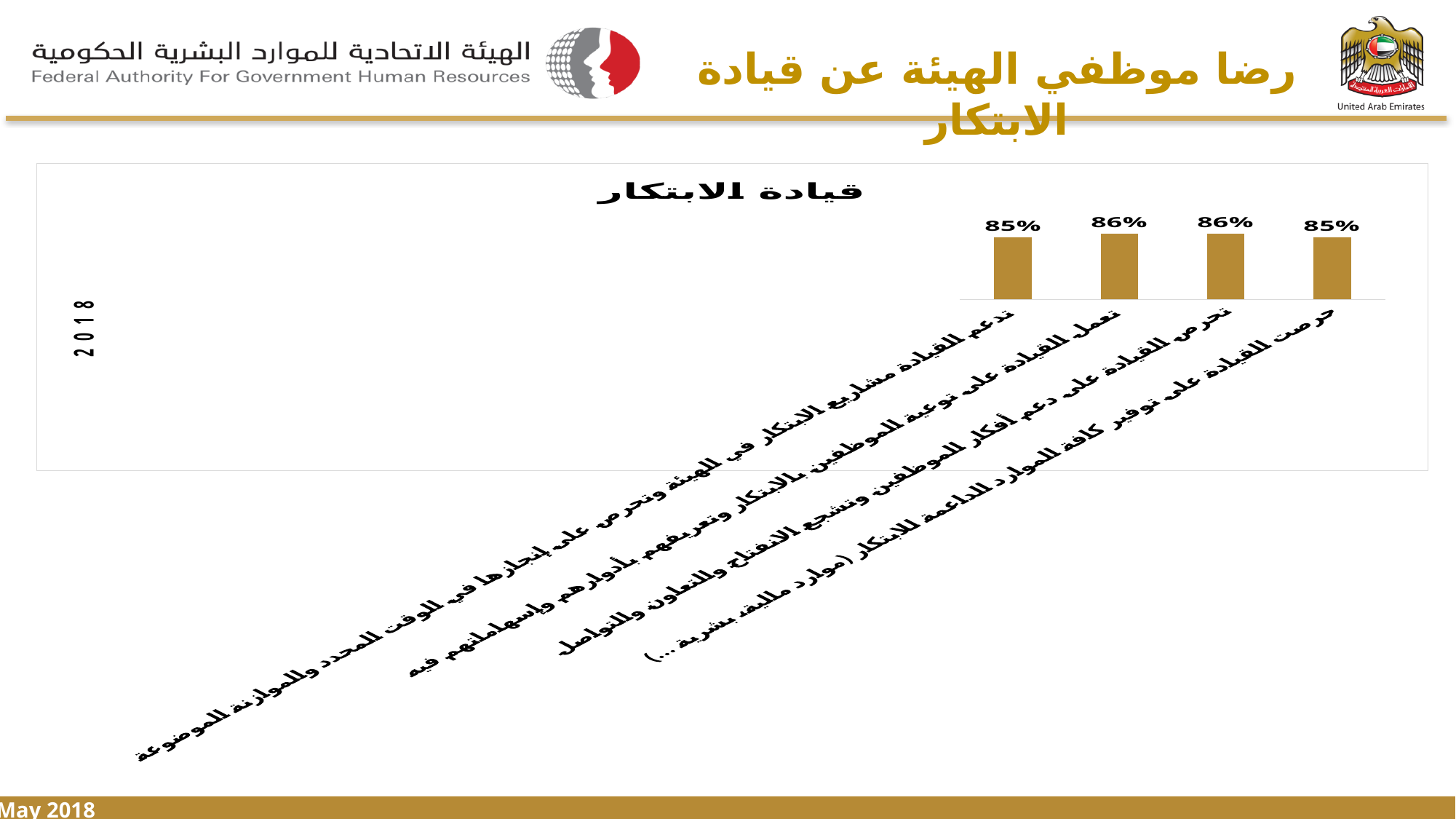
What is the value for the category "تحرص القيادة على دعم أفكار الموظفين..."? 86% What is the value for the category "تدعم القيادة مشاريع الابتكار في الهيئة..."? 85% What is the value of the rightmost bar in the chart? 85% Which year is indicated on the vertical axis label of the chart? 2018 What is the title of the chart? قيادة الابتكار What is the highest value shown in the chart? 86% What type of chart is shown on the slide? bar chart What is the value for the category "تعمل القيادة على توعية الموظفين بالابتكار..."? 86% What is the lowest value shown in the chart? 85% What is the value for the category "حرصت القيادة على توفير كافة الموارد الداعمة للابتكار..."? 85% How many bars (categories) does the chart show? 4 What is the difference between the value for "تعمل القيادة على توعية الموظفين بالابتكار..." and the value for "تدعم القيادة مشاريع الابتكار في الهيئة..."? 1%